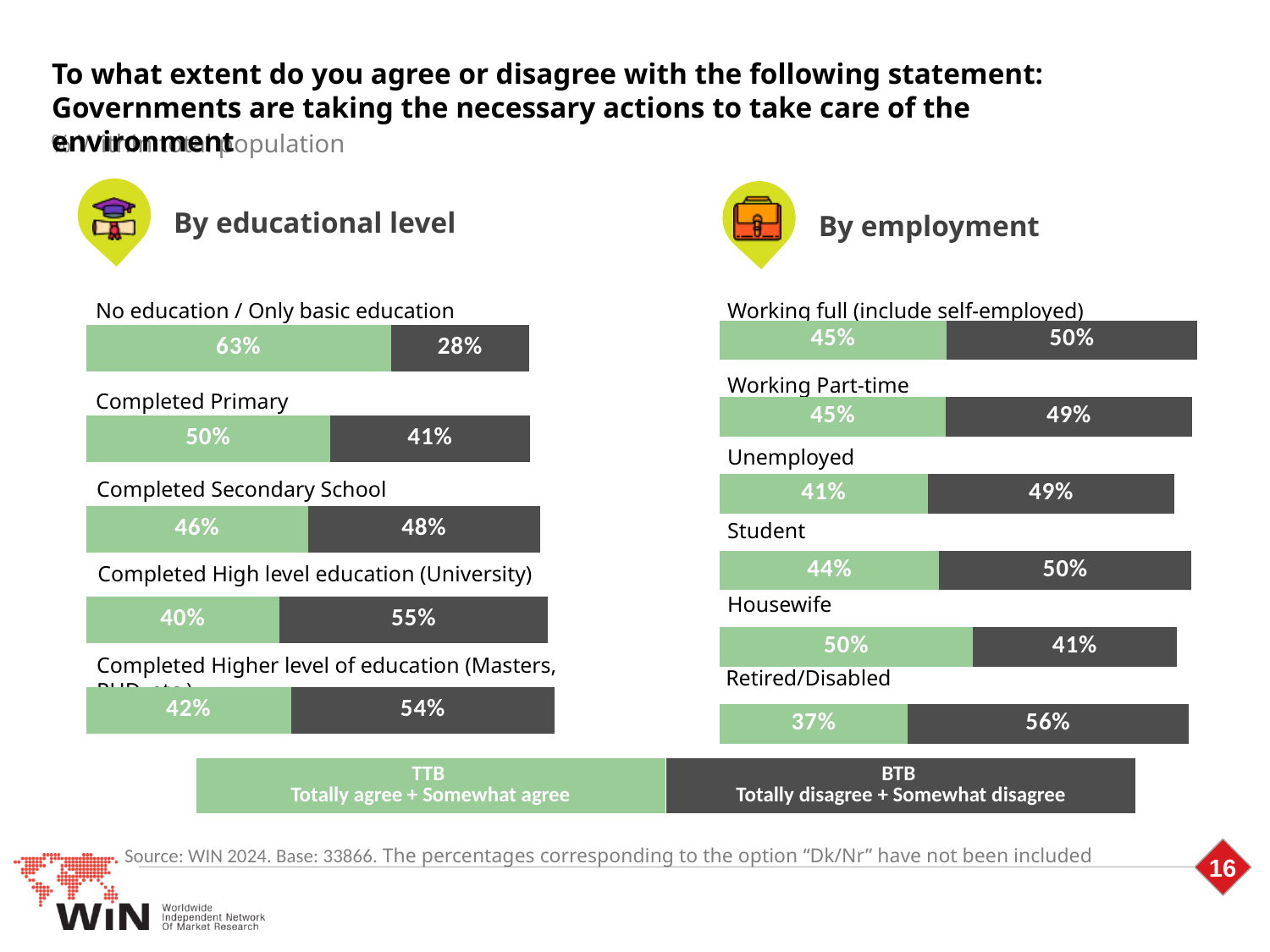
In the 'By employment' chart, which category has the lowest TTB value? Retired/Disabled What type of chart is used in the 'By educational level' section? Stacked bar chart In the 'By employment' chart, what is the TTB value for 'Housewife'? 50% In the 'By employment' chart, which is larger for 'Unemployed': the TTB value or the BTB value? BTB In the 'By educational level' chart, what is the BTB (Totally disagree + Somewhat disagree) value for 'Completed High level education (University)'? 55% In the 'By employment' chart, what is the BTB value for 'Retired/Disabled'? 56% How many series does the legend at the bottom of the slide list? 2 How many categories are shown in the 'By employment' chart? 6 In the 'By educational level' chart, what is the TTB (Totally agree + Somewhat agree) value for 'No education / Only basic education'? 63% In the 'By educational level' chart, which category has the highest TTB value? No education / Only basic education In the 'By educational level' chart, what is the difference between the TTB and BTB values for 'Completed Primary'? 9% In the 'By employment' chart, what is the total of the TTB and BTB values for 'Student'? 94%